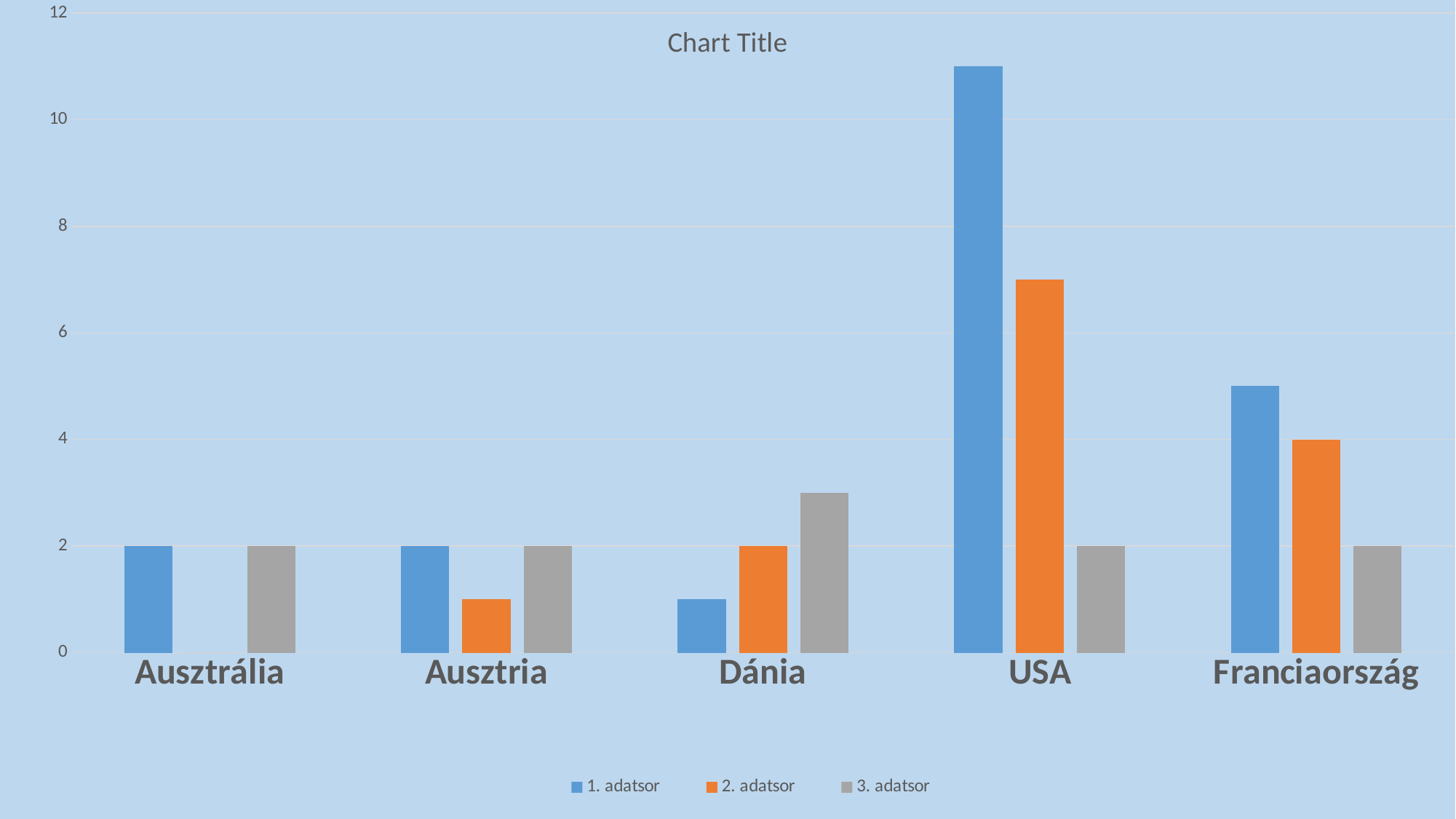
Which category has the highest value for 2. adatsor? USA Is the value for 1. adatsor in USA greater or less than 10? greater What kind of chart is shown on the slide? bar chart What is the title of the chart? Chart Title How many categories are shown on the x axis? 5 Is the value for 2. adatsor in USA greater or less than 6? greater What is the value for 3. adatsor in USA? 2 Which category has the highest value for 3. adatsor? Dánia How many series does the legend list? 3 Which is larger in Dánia, 1. adatsor or 3. adatsor? 3. adatsor Which category has the highest value for 1. adatsor? USA What is the value for 2. adatsor in Franciaország? 4